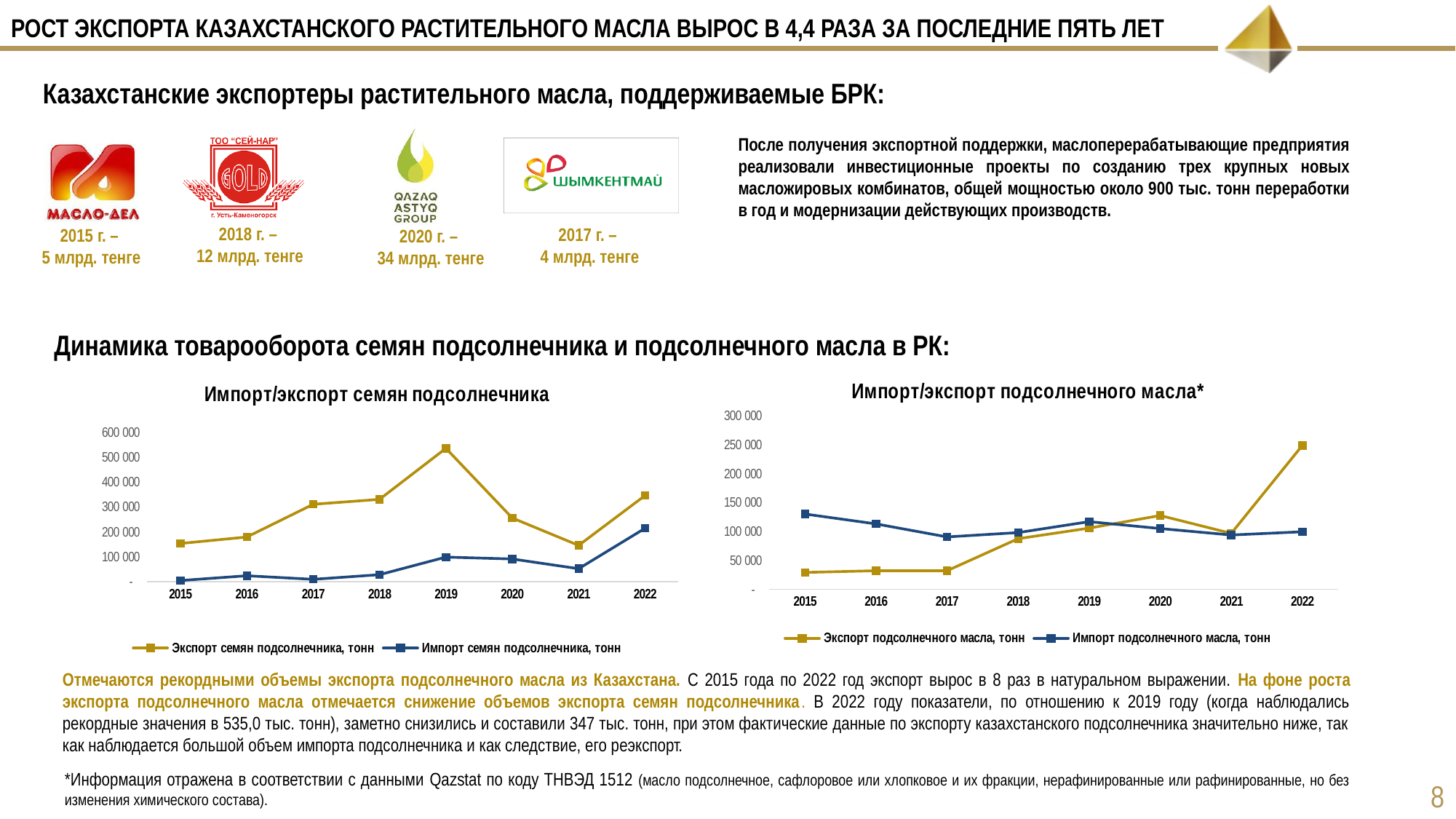
In the 'Импорт/экспорт подсолнечного масла*' chart, in which year is 'Экспорт подсолнечного масла, тонн' highest? 2022 In the 'Импорт/экспорт подсолнечного масла*' chart, does 'Экспорт подсолнечного масла, тонн' rise or fall from 2017 to 2020? rise In the 'Импорт/экспорт подсолнечного масла*' chart, is the value for 'Экспорт подсолнечного масла, тонн' in 2015 greater or less than 50 000? less In the 'Импорт/экспорт семян подсолнечника' chart, in which year is 'Экспорт семян подсолнечника, тонн' highest? 2019 In the 'Импорт/экспорт семян подсолнечника' chart, is the value for 'Экспорт семян подсолнечника, тонн' in 2019 greater or less than 500 000? greater In the 'Импорт/экспорт подсолнечного масла*' chart, in which year is 'Импорт подсолнечного масла, тонн' highest? 2015 How many years are plotted on the x axis of the 'Импорт/экспорт семян подсолнечника' chart? 8 How many series does the legend of the 'Импорт/экспорт подсолнечного масла*' chart list? 2 What kind of chart is the 'Импорт/экспорт семян подсолнечника' chart? line chart In the 'Импорт/экспорт семян подсолнечника' chart, is the value for 'Импорт семян подсолнечника, тонн' in 2015 greater or less than 100 000? less In the 'Импорт/экспорт подсолнечного масла*' chart, which is larger in 2015: 'Экспорт подсолнечного масла, тонн' or 'Импорт подсолнечного масла, тонн'? Импорт подсолнечного масла, тонн